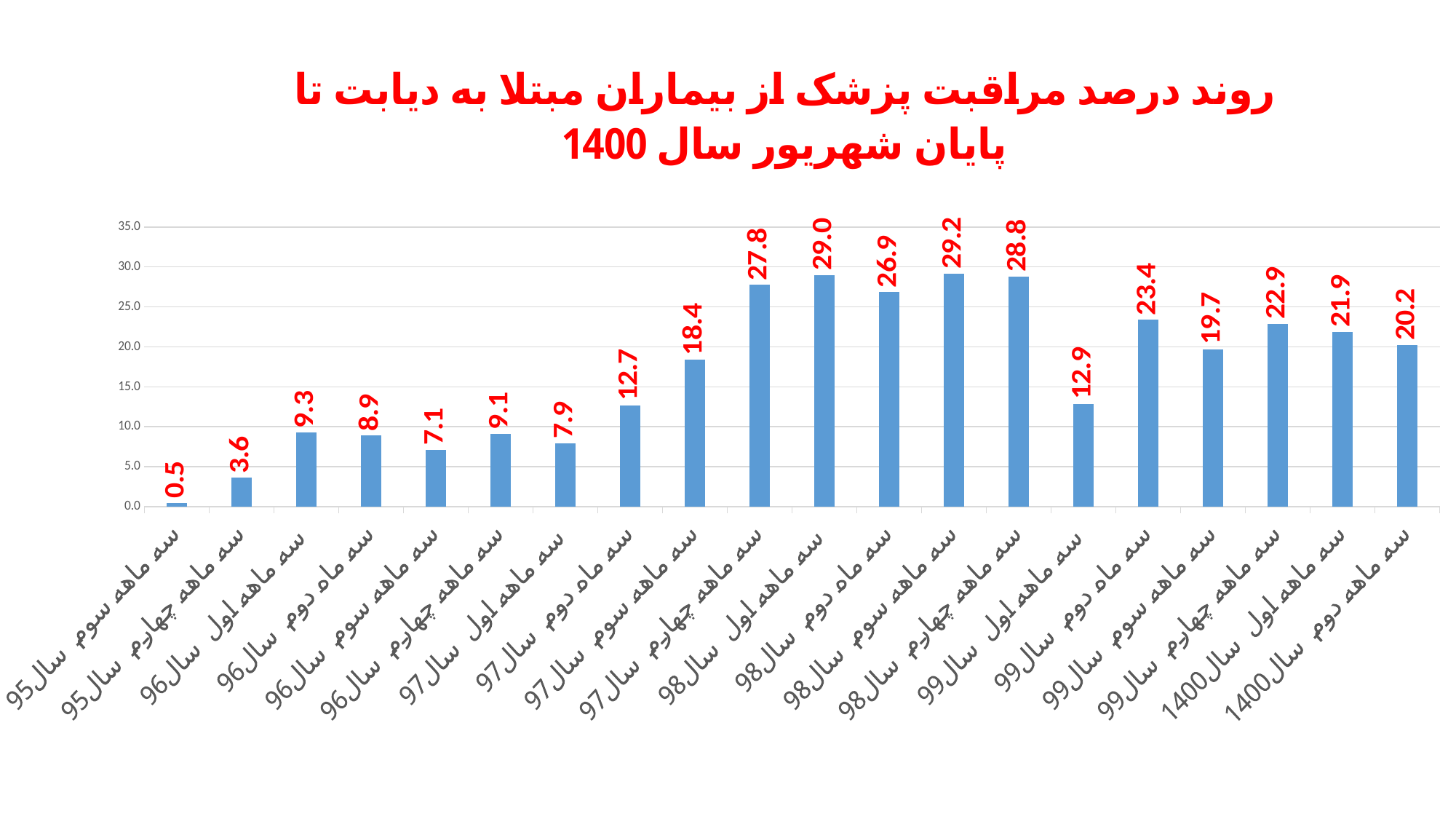
What is the difference between the values for سه ماهه چهارم سال99 and سه ماهه اول سال 1400? 1.0 Which is larger, the value for سه ماهه سوم سال97 or the value for سه ماهه دوم سال99? سه ماهه دوم سال99 What is the value for سه ماهه اول سال98? 29.0 What type of chart is shown on the slide? Bar chart What is the value for سه ماهه سوم سال95? 0.5 Which category has the lowest value? سه ماهه سوم سال95 Do the values generally rise or fall from سه ماهه سوم سال95 to سه ماهه سوم سال98? Rise How many bars are plotted in the chart? 20 What is the title of the chart? روند درصد مراقبت پزشک از بیماران مبتلا به دیابت تا پایان شهریور سال 1400 Which category has the highest value? سه ماهه سوم سال98 What is the value for سه ماهه اول سال99? 12.9 What is the value for سه ماهه دوم سال 1400? 20.2